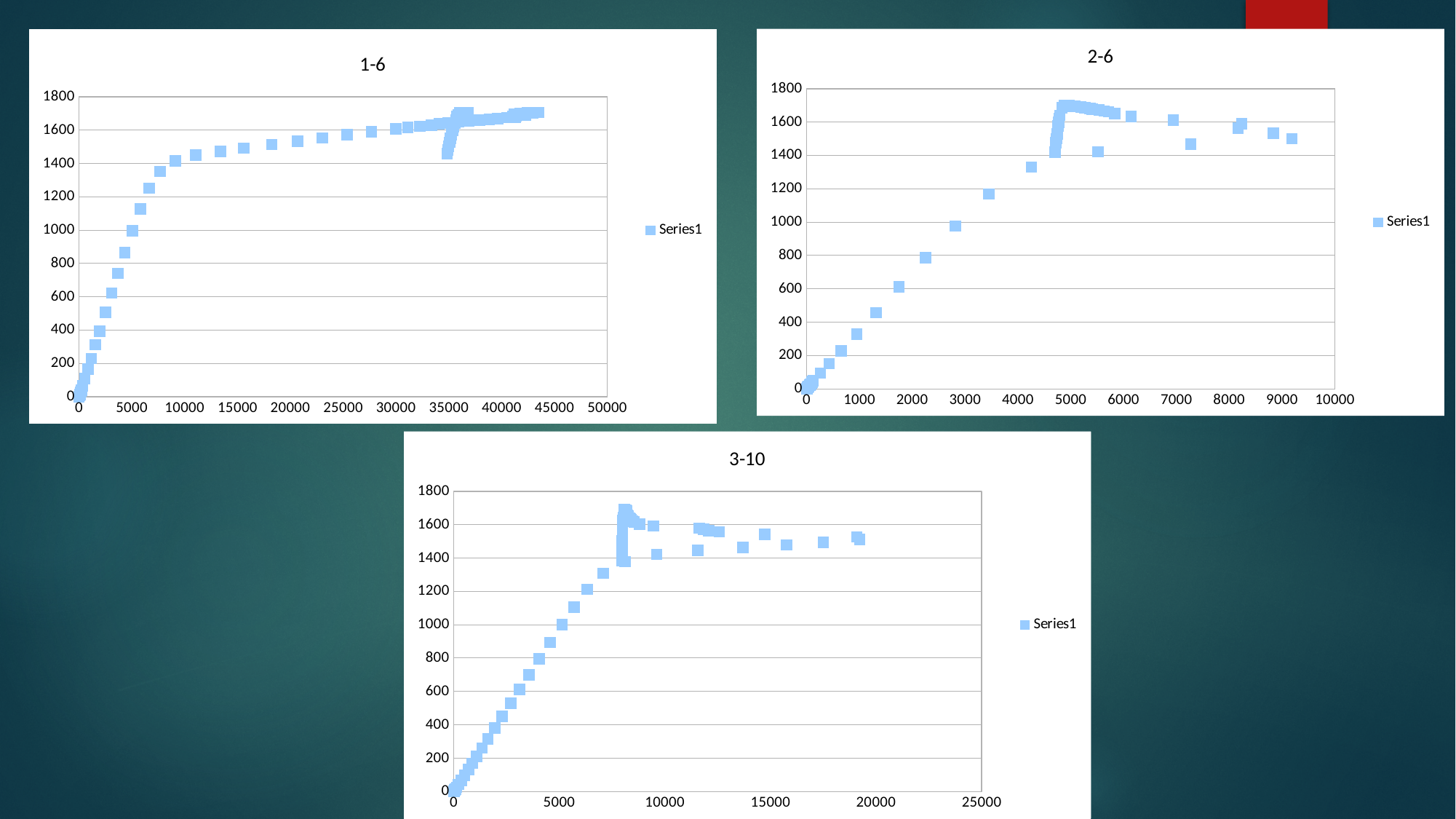
In the chart titled "2-6", do the values rise or fall along the x axis between 0 and 5000? rise What is the title of the chart at the bottom of the slide? 3-10 What is the maximum value shown on the x axis of the chart titled "1-6"? 50000 How many series does the legend of the chart titled "2-6" list? 1 What kind of chart is the chart titled "1-6"? scatter chart What is the name of the series shown in the legend of the chart titled "3-10"? Series1 In the chart titled "3-10", is the highest plotted value greater or less than 1600? greater In the chart titled "2-6", is the last plotted point (near x = 9000) greater or less than 1600? less In the chart titled "1-6", do the values generally rise or fall as the x axis increases? rise How many charts are shown on the slide? 3 In the chart titled "1-6", is the highest plotted value greater or less than 1800? less